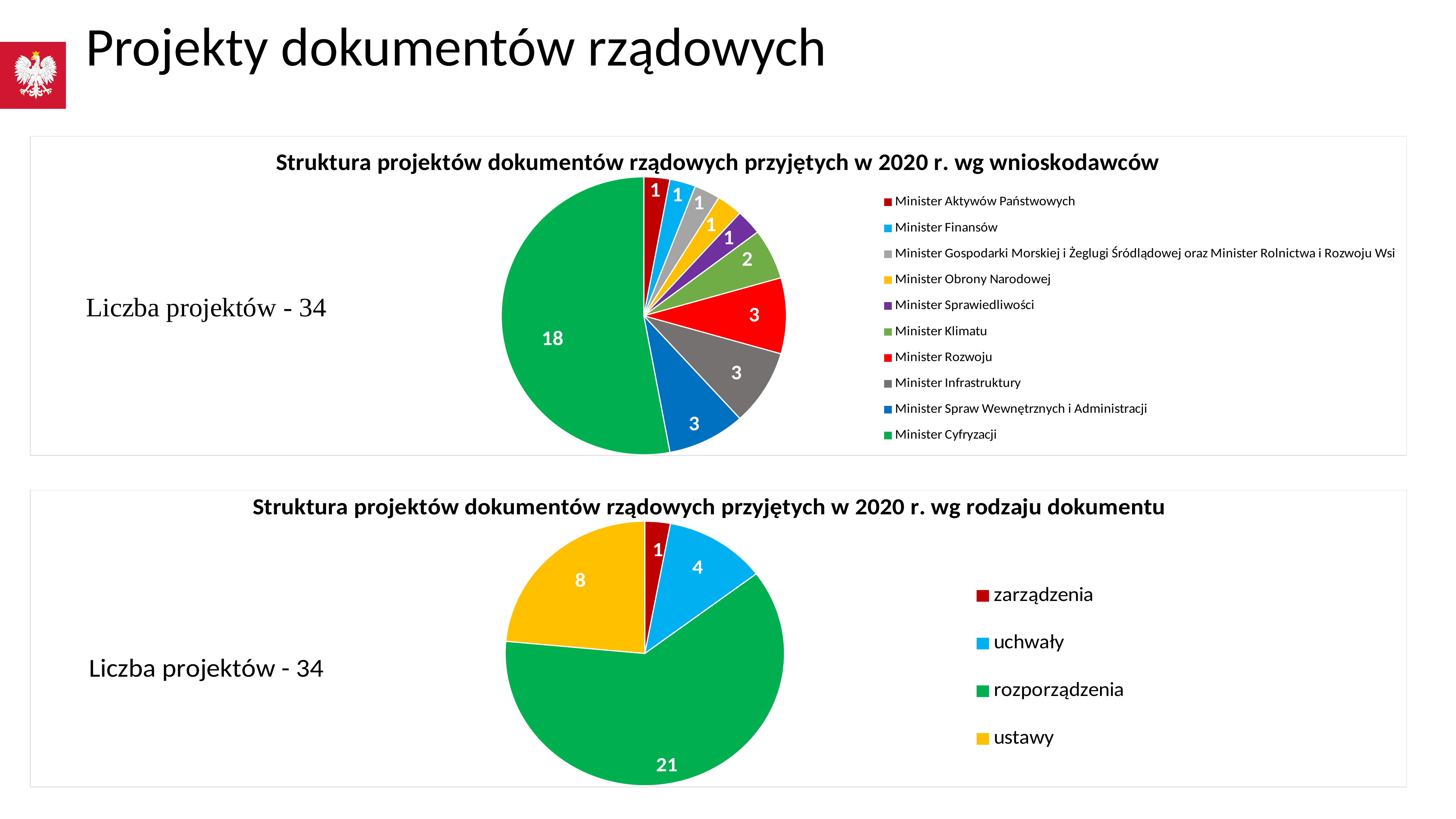
In the top chart (wg wnioskodawców), which is larger: the value for Minister Klimatu or the value for Minister Infrastruktury? Minister Infrastruktury In the bottom chart (wg rodzaju dokumentu), how many document types are shown? 4 What type of chart is used in the bottom chart (wg rodzaju dokumentu)? Pie chart In the top chart (wg wnioskodawców), how many categories does the legend list? 10 In the top chart (wg wnioskodawców), which applicant has the largest slice? Minister Cyfryzacji In the top chart (wg wnioskodawców), how many projects are attributed to Minister Cyfryzacji? 18 In the bottom chart (wg rodzaju dokumentu), how many projects are rozporządzenia? 21 In the top chart (wg wnioskodawców), what is the difference between the values for Minister Cyfryzacji and Minister Rozwoju? 15 In the bottom chart (wg rodzaju dokumentu), how many projects are ustawy? 8 In the bottom chart (wg rodzaju dokumentu), what is the difference between the values for ustawy and uchwały? 4 In the top chart (wg wnioskodawców), how many projects are attributed to Minister Klimatu? 2 In the bottom chart (wg rodzaju dokumentu), which document type has the smallest slice? zarządzenia